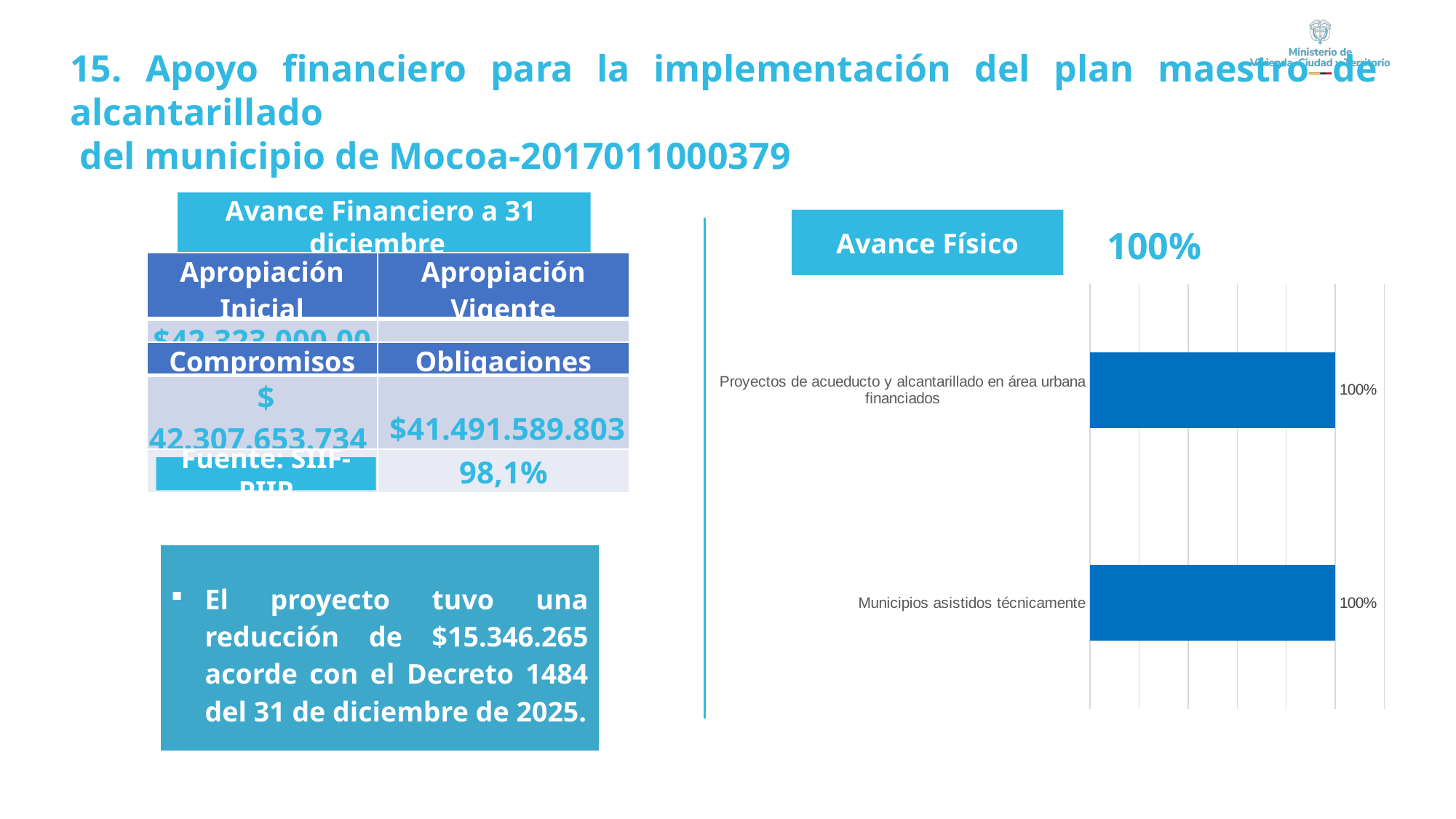
How many categories are plotted in the bar chart? 2 What type of chart is shown on the slide? bar chart What is the difference between the value for "Municipios asistidos técnicamente" and the value for "Proyectos de acueducto y alcantarillado en área urbana financiados"? 0% What is the value shown for "Municipios asistidos técnicamente"? 100% What colour are the bars in the chart? blue What is the heading shown above the bar chart? Avance Físico Are the bars in the chart horizontal or vertical? horizontal Do the two bars in the chart have the same value? yes What is the value shown for "Proyectos de acueducto y alcantarillado en área urbana financiados"? 100%